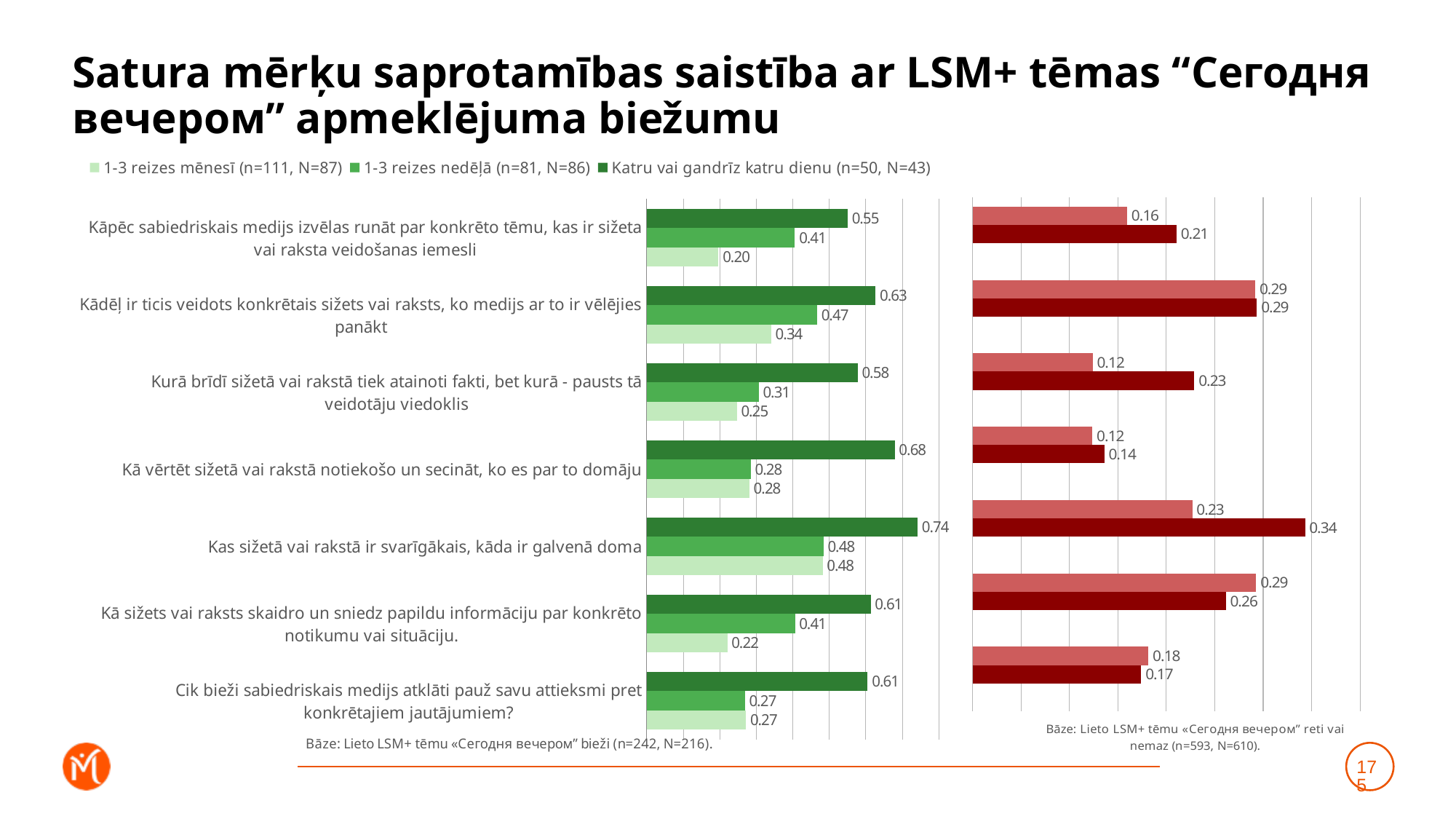
In the green bar chart on the left, which is larger for "Kā sižets vai raksts skaidro un sniedz papildu informāciju par konkrēto notikumu vai situāciju.": the "1-3 reizes nedēļā" value or the "1-3 reizes mēnesī" value? 1-3 reizes nedēļā In the red bar chart on the right, what is the value of the upper (lighter) bar for "Kāpēc sabiedriskais medijs izvēlas runāt par konkrēto tēmu, kas ir sižeta vai raksta veidošanas iemesli"? 0.16 In the red bar chart on the right, what is the value of the lower (darker) bar for "Kas sižetā vai rakstā ir svarīgākais, kāda ir galvenā doma"? 0.34 In the green bar chart on the left, which category has the highest value for "Katru vai gandrīz katru dienu"? Kas sižetā vai rakstā ir svarīgākais, kāda ir galvenā doma In the green bar chart on the left, what is the difference between the "Katru vai gandrīz katru dienu" and "1-3 reizes mēnesī" values for "Kā vērtēt sižetā vai rakstā notiekošo un secināt, ko es par to domāju"? 0.40 In the green bar chart on the left, what is the value for "Katru vai gandrīz katru dienu" for "Kas sižetā vai rakstā ir svarīgākais, kāda ir galvenā doma"? 0.74 In the green bar chart on the left, what is the value for "1-3 reizes mēnesī" for "Kādēļ ir ticis veidots konkrētais sižets vai raksts, ko medijs ar to ir vēlējies panākt"? 0.34 How many series does the legend of the green bar chart on the left list? 3 In the green bar chart on the left, what is the value for "1-3 reizes nedēļā" for "Kurā brīdī sižetā vai rakstā tiek atainoti fakti, bet kurā - pausts tā veidotāju viedoklis"? 0.31 What kind of chart is the chart on the left of the slide? Bar chart How many categories are shown in the green bar chart on the left? 7 In the green bar chart on the left, which category has the lowest value for "1-3 reizes mēnesī"? Kāpēc sabiedriskais medijs izvēlas runāt par konkrēto tēmu, kas ir sižeta vai raksta veidošanas iemesli